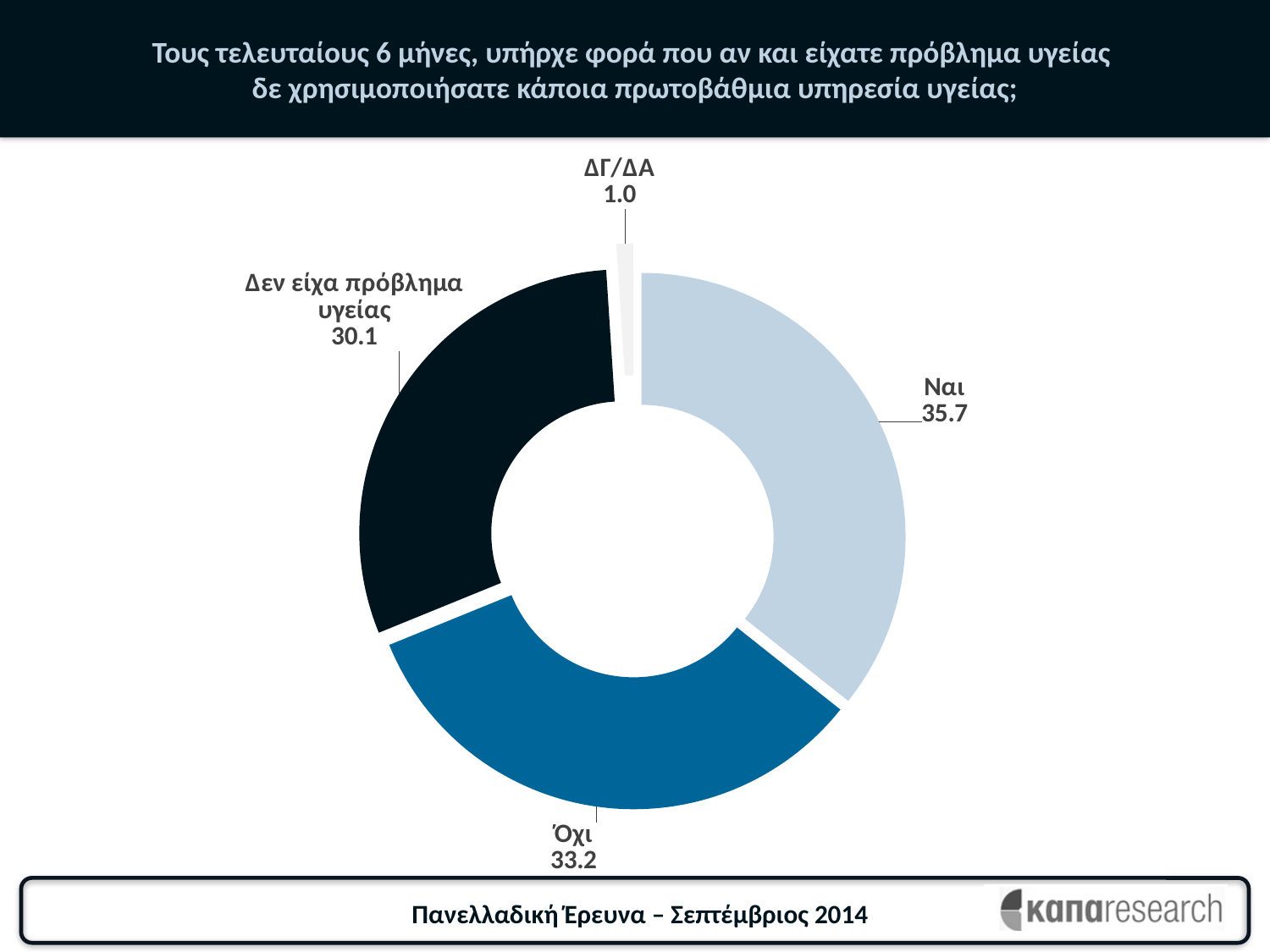
Which category has the largest slice? Ναι What value is shown for the "Ναι" slice? 35.7 What value is shown for the "Δεν είχα πρόβλημα υγείας" slice? 30.1 How many categories are shown in the chart? 4 What value is shown for the "Όχι" slice? 33.2 Which category has the smallest slice? ΔΓ/ΔΑ Which is larger, the value for "Ναι" or the value for "Δεν είχα πρόβλημα υγείας"? Ναι What colour is the "Όχι" slice? Blue What is the difference between the values for "Όχι" and "Δεν είχα πρόβλημα υγείας"? 3.1 What value is shown for the "ΔΓ/ΔΑ" slice? 1.0 What kind of chart is shown on the slide? Pie chart (doughnut) What is the difference between the values for "Ναι" and "Όχι"? 2.5